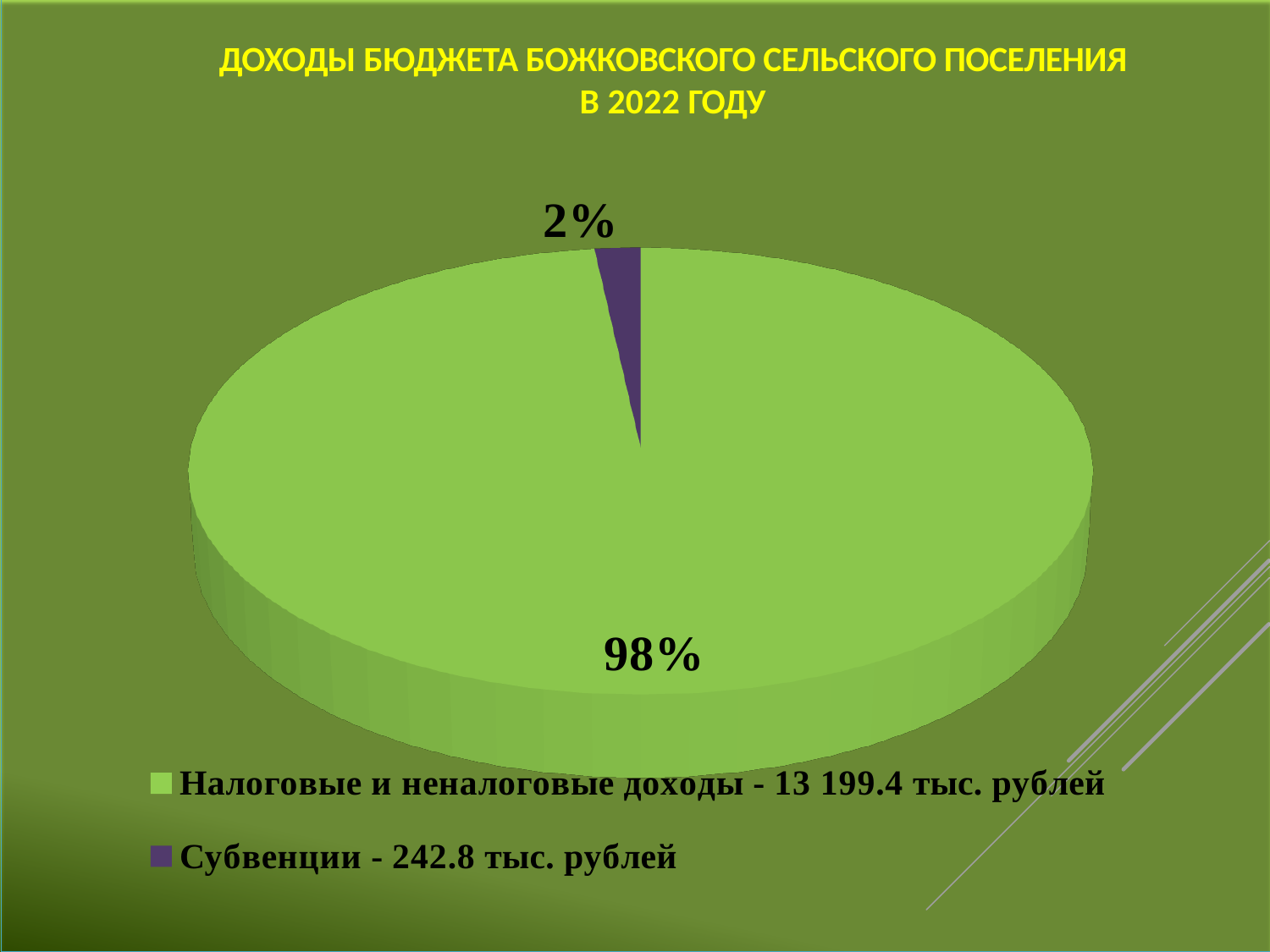
What colour is the "Субвенции" slice of the pie? purple What is the difference in percentage points between the "Налоговые и неналоговые доходы" slice and the "Субвенции" slice? 96 percentage points What share of the pie does "Субвенции" represent? 2% How many slices does the pie chart have? 2 Which is larger: the share for "Субвенции" or the share for "Налоговые и неналоговые доходы"? Налоговые и неналоговые доходы Which category has the largest slice of the pie? Налоговые и неналоговые доходы How many entries does the legend list? 2 What share of the pie does "Налоговые и неналоговые доходы" represent? 98% What kind of chart is shown on the slide? pie chart What amount in thousand rubles is given in the legend for "Субвенции"? 242.8 тыс. рублей What amount in thousand rubles is given in the legend for "Налоговые и неналоговые доходы"? 13 199.4 тыс. рублей Which category has the smallest slice of the pie? Субвенции